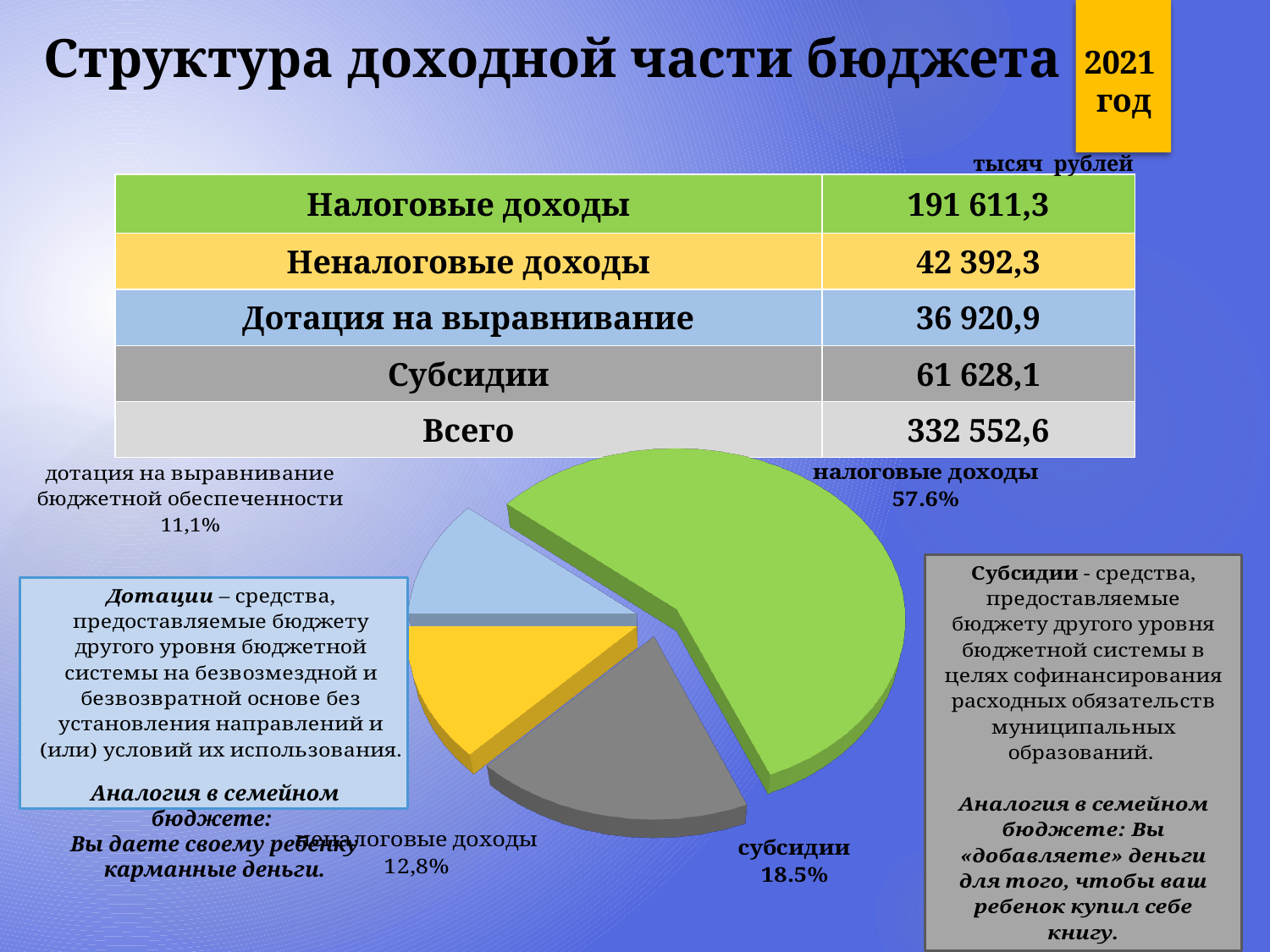
Which slice of the pie chart is the largest? налоговые доходы What kind of chart is shown on the slide? pie chart In the pie chart, what is the difference between the shares of неналоговые доходы and дотация на выравнивание бюджетной обеспеченности? 1,7% What colour is the субсидии slice in the pie chart? grey In the pie chart, which is larger: субсидии or неналоговые доходы? субсидии Which slice of the pie chart is the smallest? дотация на выравнивание бюджетной обеспеченности How many slices does the pie chart have? 4 What share of the pie chart is labelled дотация на выравнивание бюджетной обеспеченности? 11,1% What colour is the налоговые доходы slice in the pie chart? green What share of the pie chart is labelled налоговые доходы? 57.6% What share of the pie chart is labelled субсидии? 18.5%